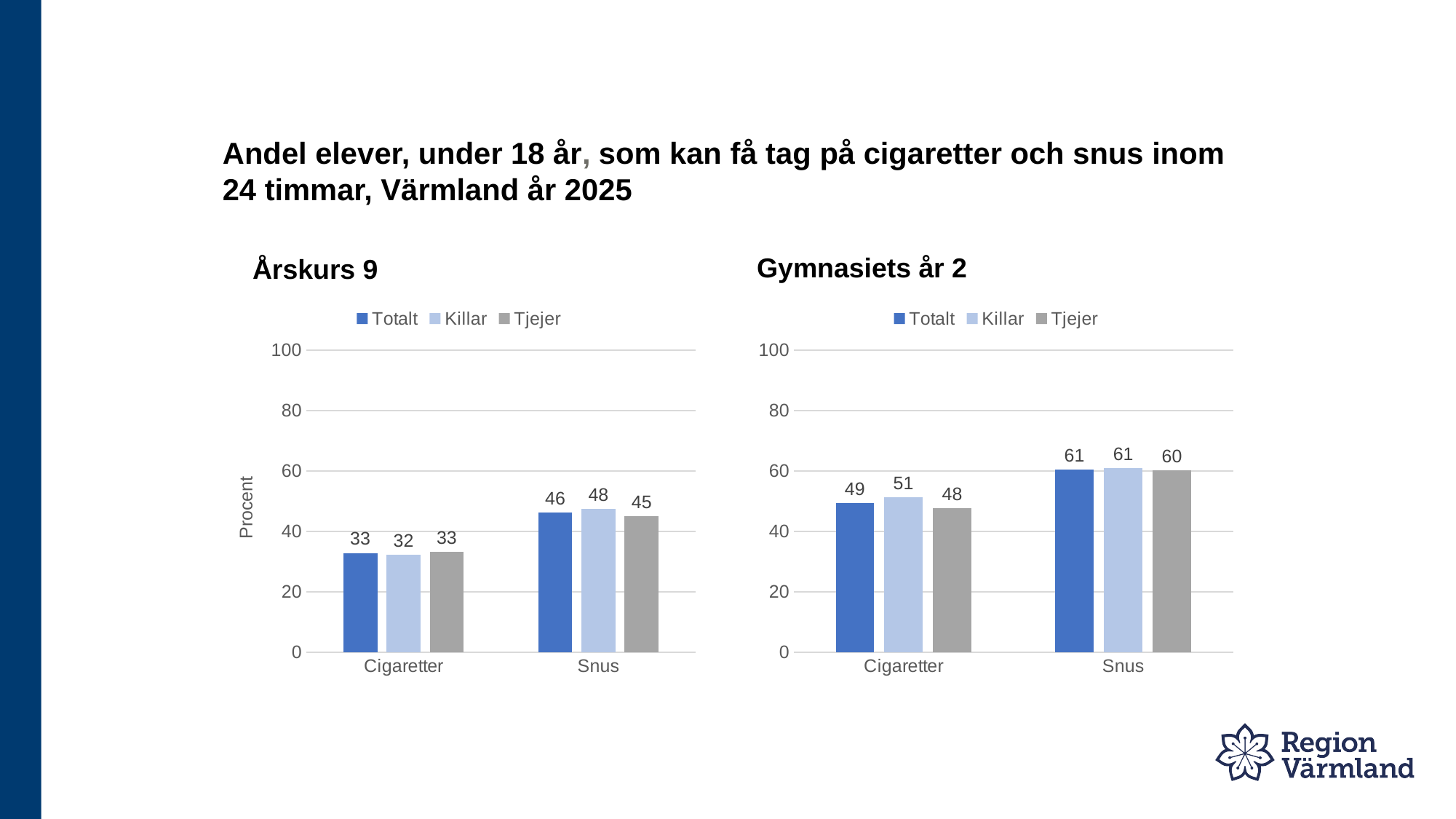
In the Gymnasiets år 2 chart, is the Totalt value for Snus greater or less than 60? greater In the Gymnasiets år 2 chart, what is the value for Tjejer for Cigaretter? 48 In the Årskurs 9 chart, what is the difference between the Totalt values for Snus and Cigaretter? 13 What is the y-axis label of the Årskurs 9 chart? Procent How many series does the legend of the Årskurs 9 chart list? 3 In the Gymnasiets år 2 chart, what is the difference between Killar and Tjejer for Cigaretter? 3 What kind of chart is the Gymnasiets år 2 chart? Bar chart In the Årskurs 9 chart, what is the value for Killar for Cigaretter? 32 In the Gymnasiets år 2 chart, what is the value for Killar for Snus? 61 How many categories are shown on the x axis of the Gymnasiets år 2 chart? 2 In the Årskurs 9 chart, what is the value for Totalt for Snus? 46 In the Årskurs 9 chart, which is larger for Snus: Killar or Tjejer? Killar